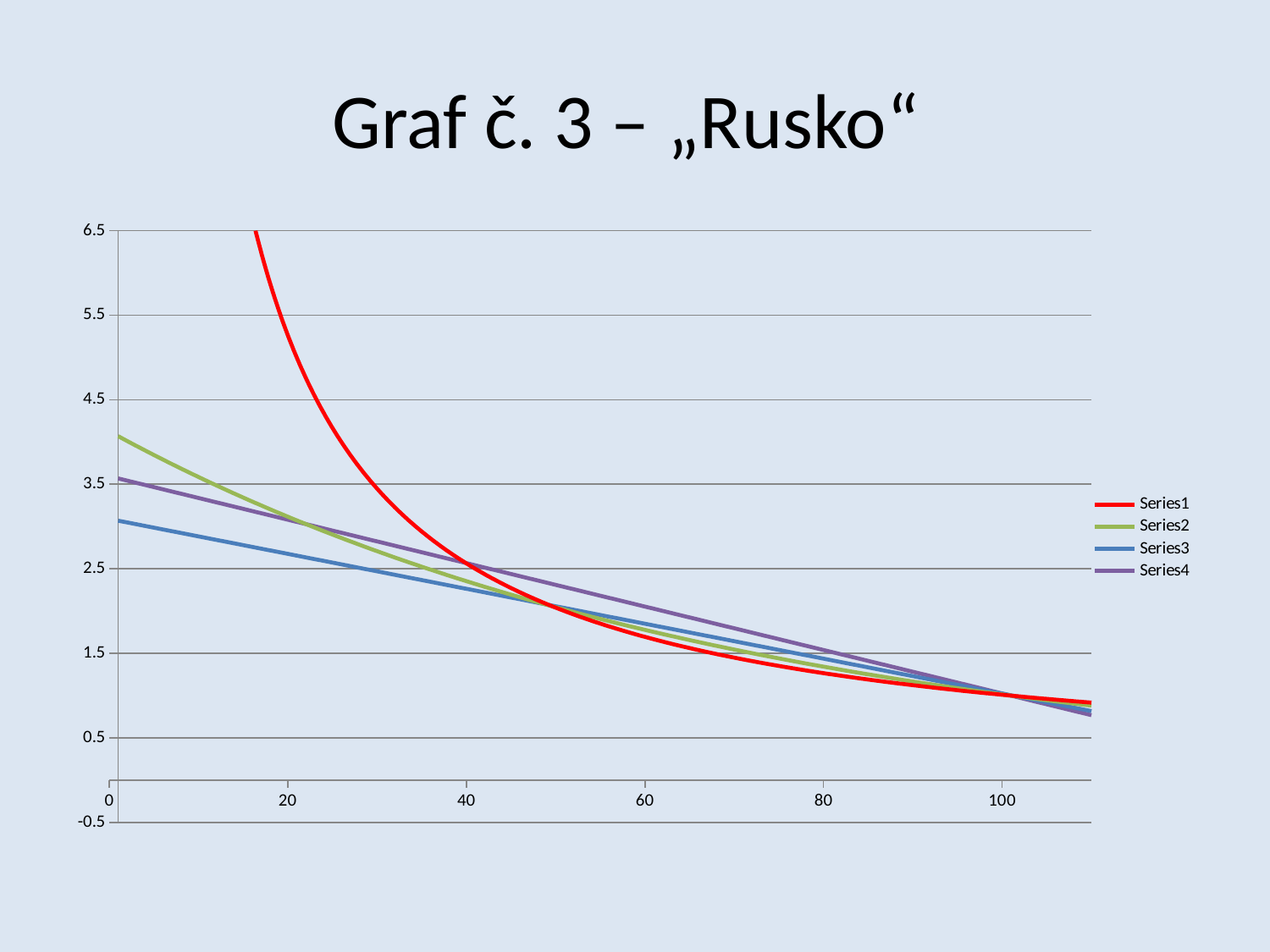
Is the value of Series2 at x = 0 greater or less than 4.5? less What is the title of the chart? Graf č. 3 – „Rusko“ Which series has the lowest value at x = 0? Series3 What kind of chart is shown on the slide? Line chart Which colour is used for Series1? Red Is the value of Series1 at x = 80 greater or less than 1.5? less Which series has the highest value at x = 0? Series1 Do the values of Series3 rise or fall along the x axis? Fall Do the values of Series1 rise or fall as x increases? Fall How many series does the legend list? 4 Which series has the lowest value at x = 80? Series1 At x = 20, which is larger: Series1 or Series4? Series1